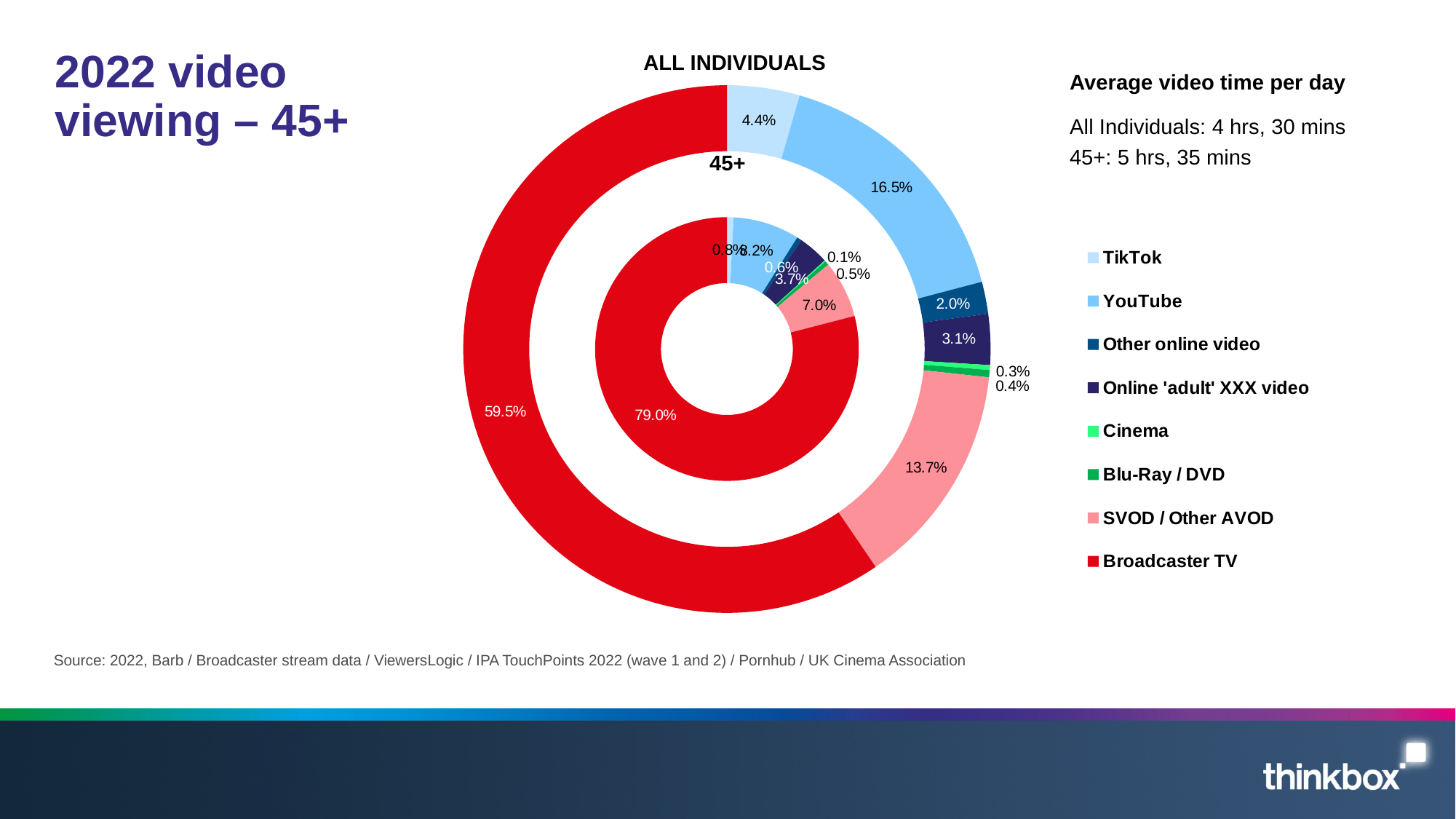
Which category has the smallest share in the outer ALL INDIVIDUALS ring? Cinema Which category has the largest share in the inner 45+ ring? Broadcaster TV In the inner 45+ ring, what share of video viewing is Broadcaster TV? 79.0% What is the difference between the Broadcaster TV share in the 45+ ring and in the ALL INDIVIDUALS ring? 19.5 percentage points In the outer ALL INDIVIDUALS ring, what is the value for YouTube? 16.5% According to the text on the slide, what is the average video time per day for 45+? 5 hrs, 35 mins How many categories does the legend list? 8 In the inner 45+ ring, what is the value for SVOD / Other AVOD? 7.0% What kind of chart is shown on the slide? Doughnut chart Which is larger in the outer ALL INDIVIDUALS ring: YouTube or SVOD / Other AVOD? YouTube In the outer ALL INDIVIDUALS ring, what is the value for SVOD / Other AVOD? 13.7% In the outer ALL INDIVIDUALS ring, what share of video viewing is Broadcaster TV? 59.5%